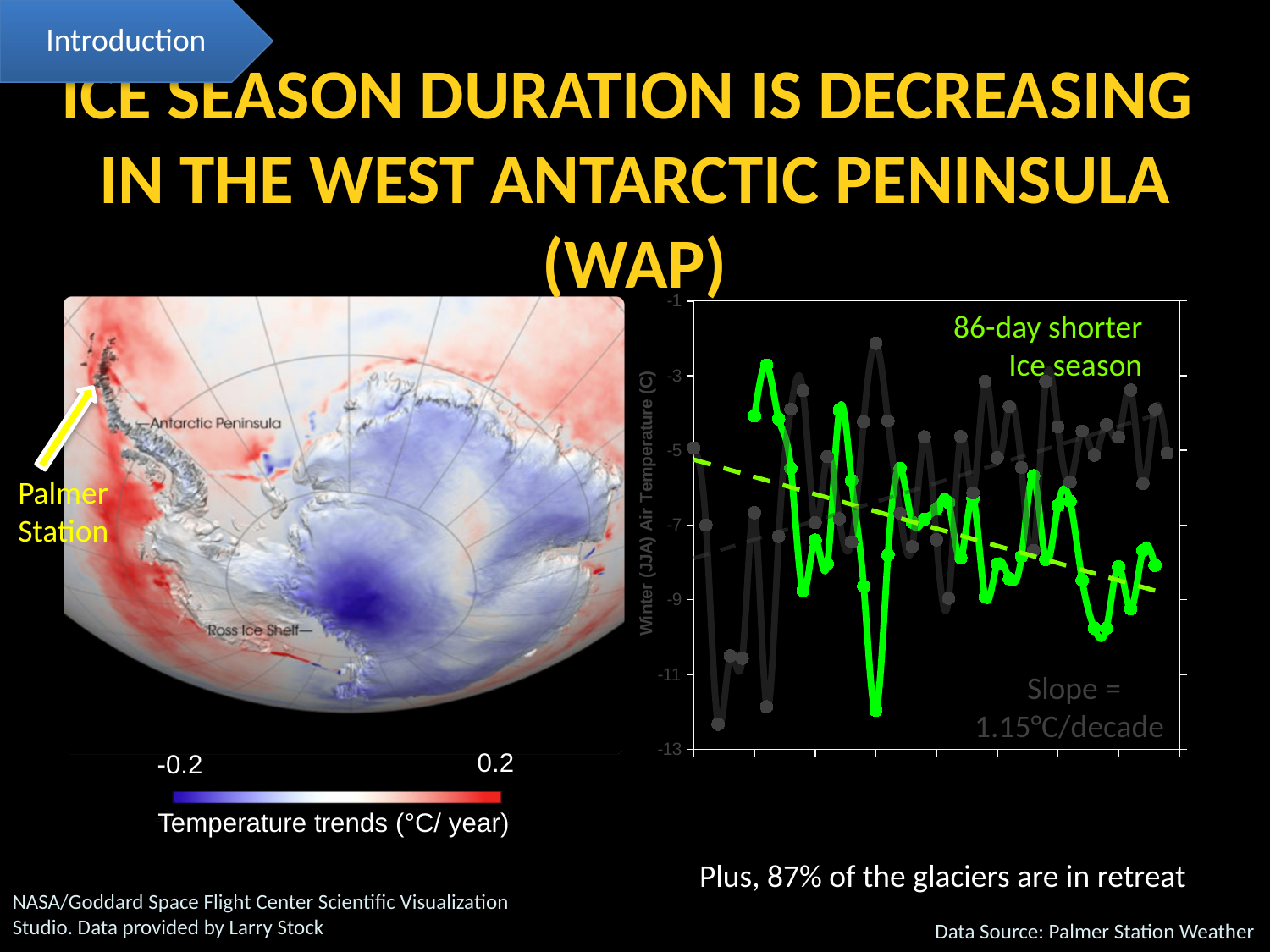
What is the label on the y axis of the line chart? Winter (JJA) Air Temperature (C) Is the highest point of the grey series on the line chart greater or less than -3? greater What slope value is printed on the line chart? 1.15°C/decade Is the lowest point of the green series on the line chart greater or less than -11? less According to the annotation on the line chart, how much shorter is the ice season? 86-day How many data series (lines) are plotted on the line chart? 2 What kind of chart is shown on the right side of the slide? line chart Does the green dashed trend line on the line chart rise or fall from left to right? fall At the right end of the line chart, which dashed trend line is higher, the grey one or the green one? grey Does the grey dashed trend line on the line chart rise or fall from left to right? rise What is the lowest tick value shown on the y axis of the line chart? -13